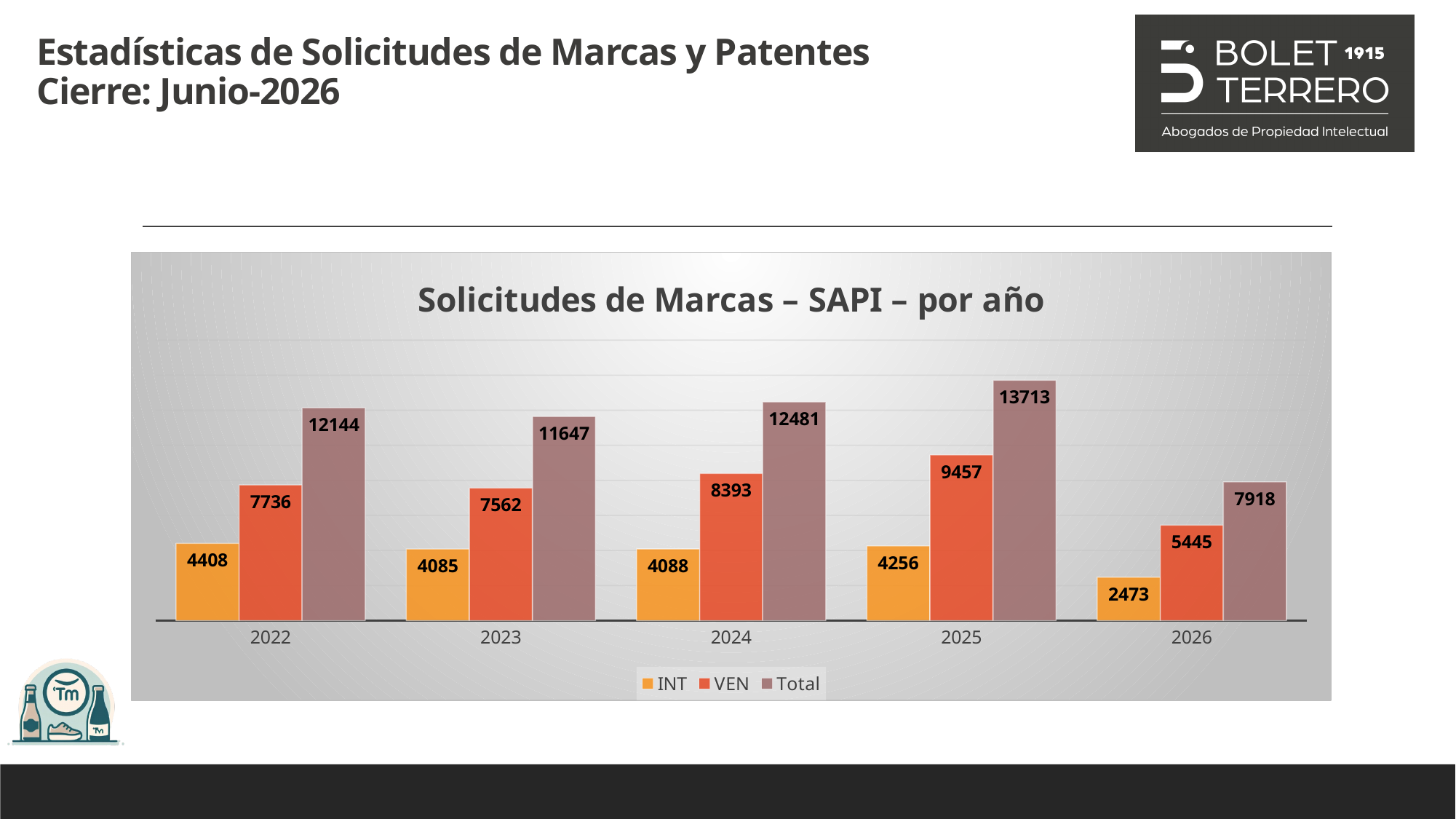
Which year has the lowest INT value? 2026 How many series does the legend list? 3 Which is larger, the Total value for 2022 or the Total value for 2023? 2022 Which year has the highest Total value? 2025 What is the title of the chart? Solicitudes de Marcas – SAPI – por año How many years are shown on the x axis? 5 What is the VEN value for 2024? 8393 What is the INT value for 2022? 4408 What is the difference between the VEN values for 2025 and 2024? 1064 Does the VEN value rise or fall from 2022 to 2025? Rise What is the Total value for 2025? 13713 What kind of chart is shown on the slide? Bar chart